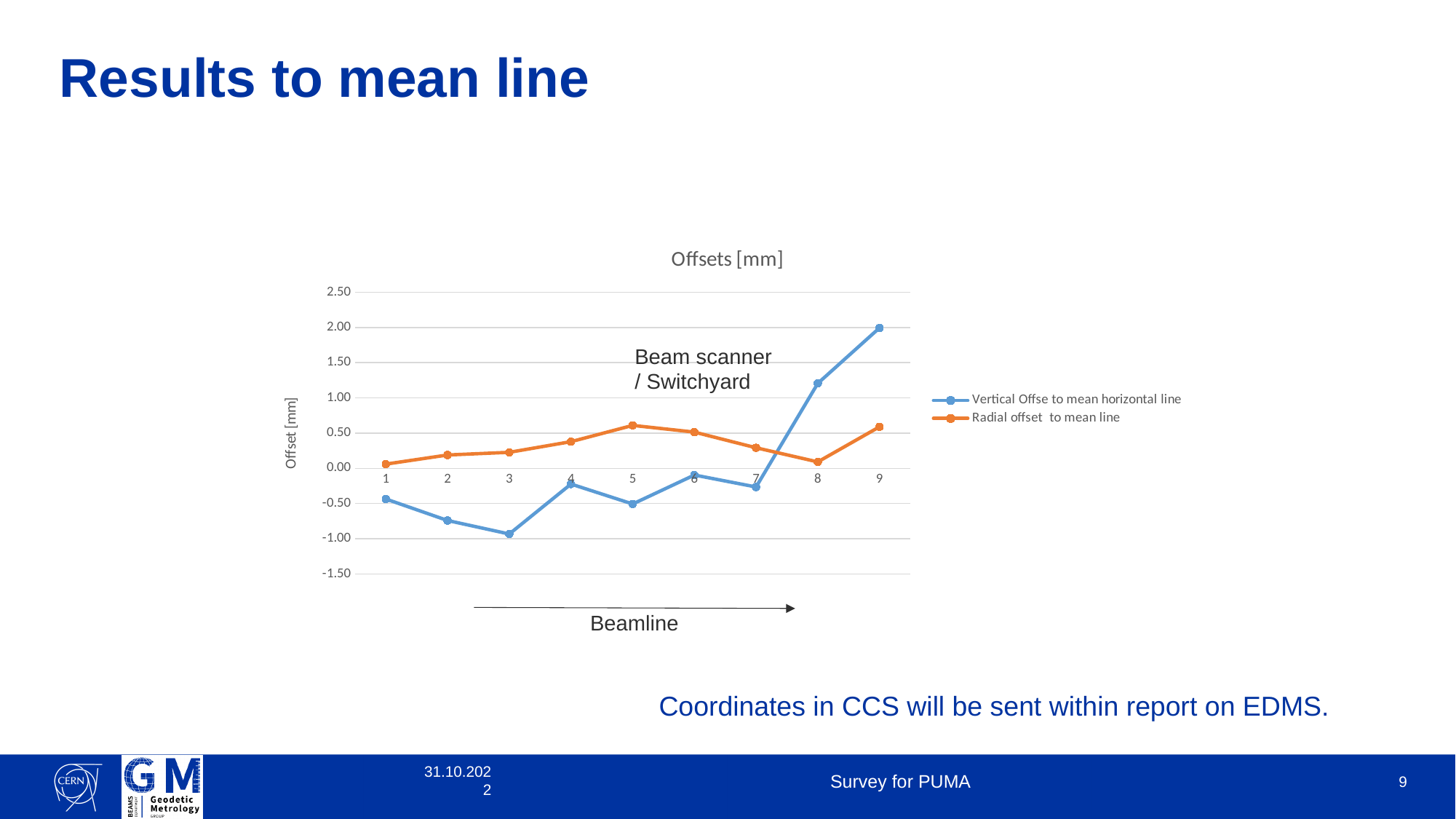
At which x-axis position is the Vertical Offse to mean horizontal line series highest? 9 Does the Vertical Offse to mean horizontal line series rise or fall from position 7 to position 9? rise How many series does the legend list? 2 At position 3, which series has the larger value: Vertical Offse to mean horizontal line or Radial offset to mean line? Radial offset to mean line At position 9, which series has the larger value: Vertical Offse to mean horizontal line or Radial offset to mean line? Vertical Offse to mean horizontal line What is the title of the chart? Offsets [mm] How many points are plotted along the x axis for each series? 9 At which x-axis position is the Vertical Offse to mean horizontal line series lowest? 3 Is the value of the Radial offset to mean line series at position 4 greater or less than 0.50? less What kind of chart is shown on the slide? line chart Is the value of the Vertical Offse to mean horizontal line series at position 3 greater or less than -0.50? less Is the value of the Vertical Offse to mean horizontal line series at position 9 greater or less than 1.50? greater